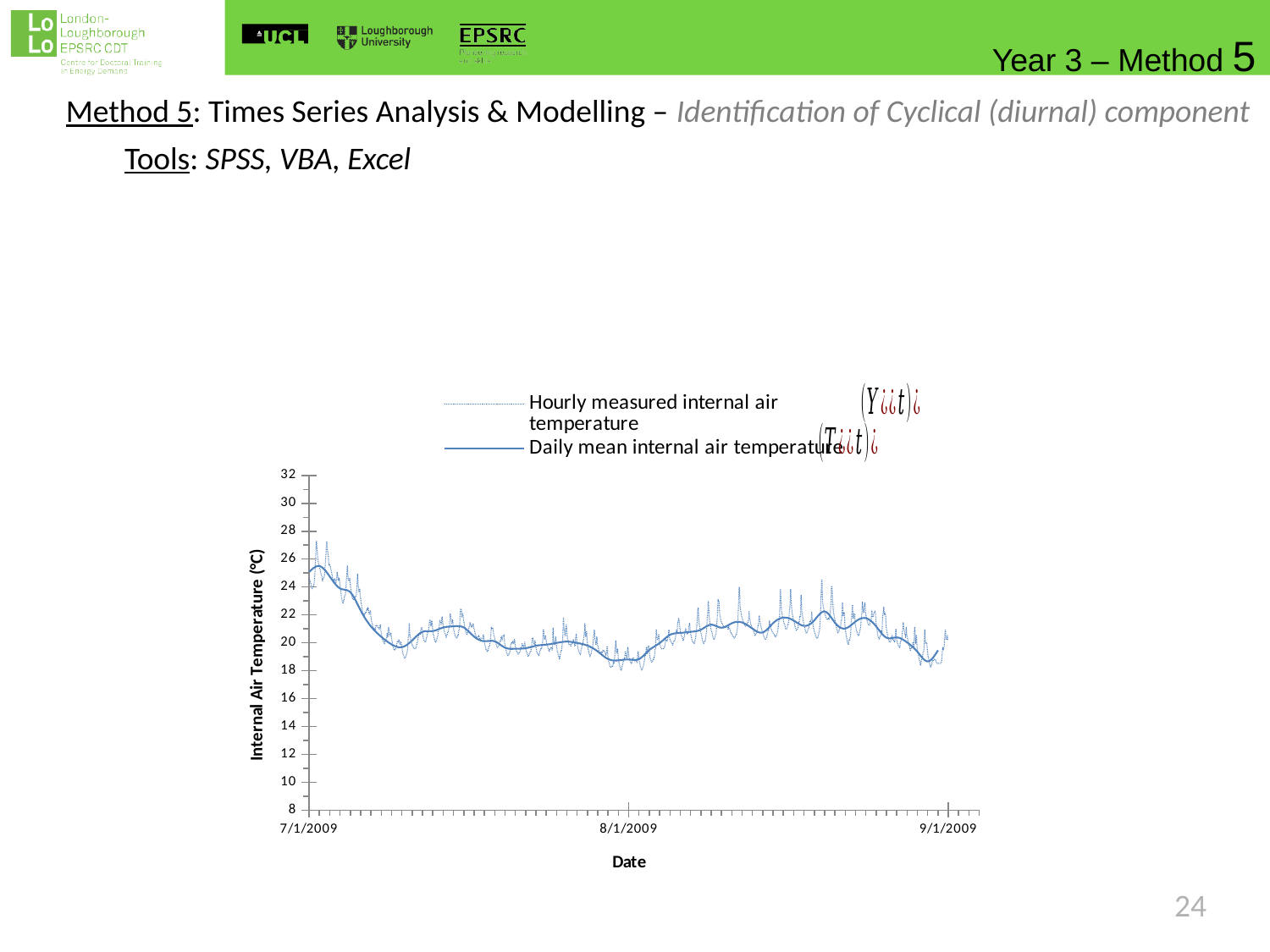
What is the label of the y axis of the chart? Internal Air Temperature (°C) What is the last date tick shown on the x axis of the chart? 9/1/2009 Is the highest hourly measured internal air temperature on the chart greater or less than 30? less Does the daily mean internal air temperature rise or fall overall between 7/1/2009 and 8/1/2009? fall Is the lowest hourly measured internal air temperature on the chart greater or less than 16? greater What is the first date tick shown on the x axis of the chart? 7/1/2009 Is the daily mean internal air temperature around 8/1/2009 greater or less than 20? less How many series does the chart legend list? 2 What is the label of the x axis of the chart? Date What kind of chart is shown on the slide? line chart